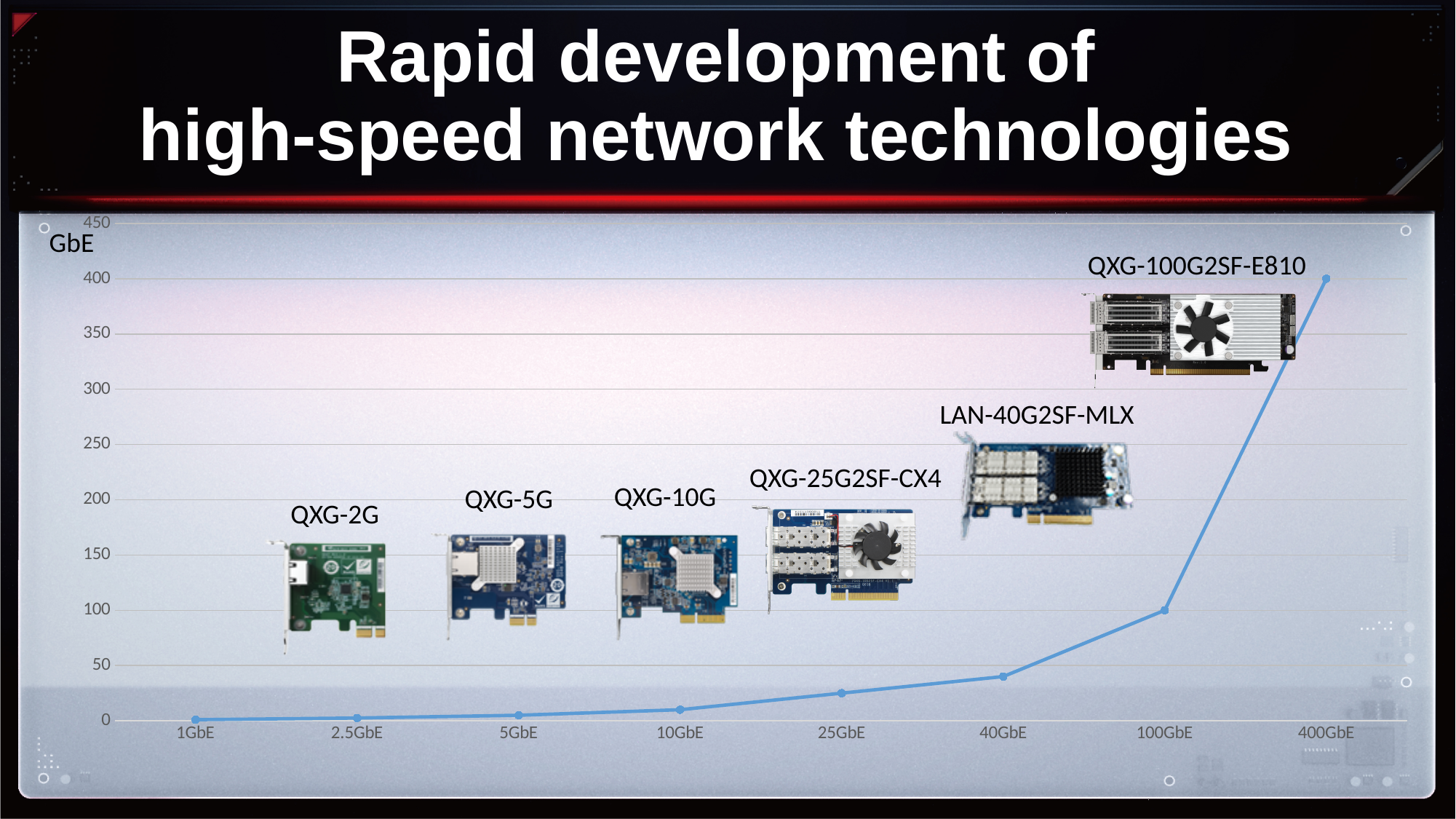
Is the value for 400GbE greater or less than 350? greater What is the value plotted for 100GbE? 100 How many data points are plotted on the line? 8 What is the value plotted for 400GbE? 400 Is the value for 40GbE greater or less than 50? less What kind of chart is shown on the slide? line chart What is the difference between the values for 400GbE and 100GbE? 300 Do the values rise or fall moving from left to right along the x axis? rise Which has the larger value, 100GbE or 40GbE? 100GbE Which product name is labelled next to the 400GbE data point? QXG-100G2SF-E810 What unit label is shown at the top of the y axis? GbE Which category has the highest value on the chart? 400GbE